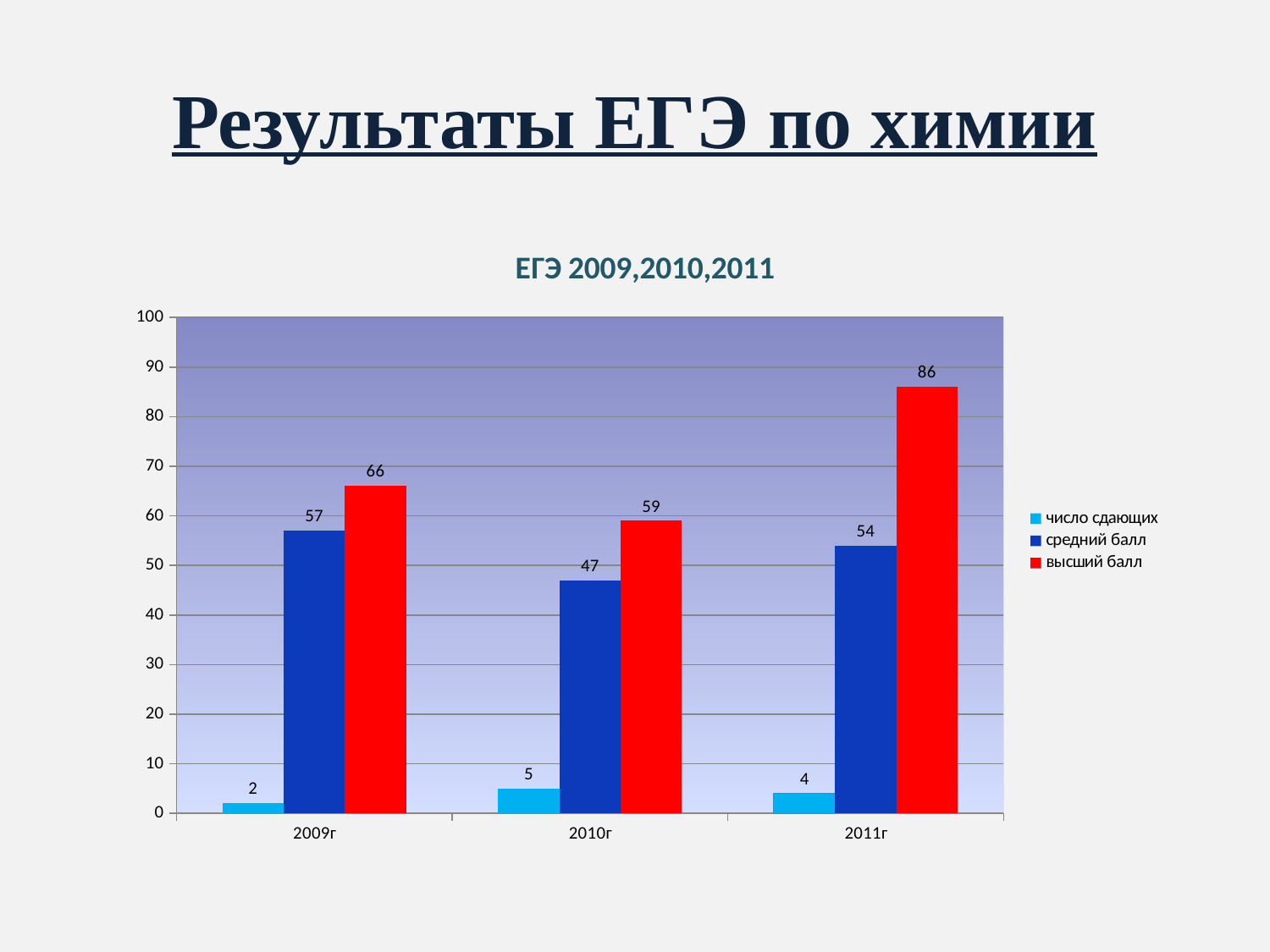
What is the difference between "высший балл" in 2011г and in 2009г? 20 What kind of chart is shown? bar chart What is the title of the chart? ЕГЭ 2009,2010,2011 What is the value of "число сдающих" for 2009г? 2 Which is larger: "средний балл" in 2009г or in 2011г? 2009г How many years are shown on the x axis? 3 In which year is "высший балл" the highest? 2011г What is the value of "высший балл" for 2011г? 86 What is the value of "средний балл" for 2010г? 47 Is the value of "высший балл" for 2010г greater or less than 50? greater How many series does the legend list? 3 In which year is "средний балл" the lowest? 2010г